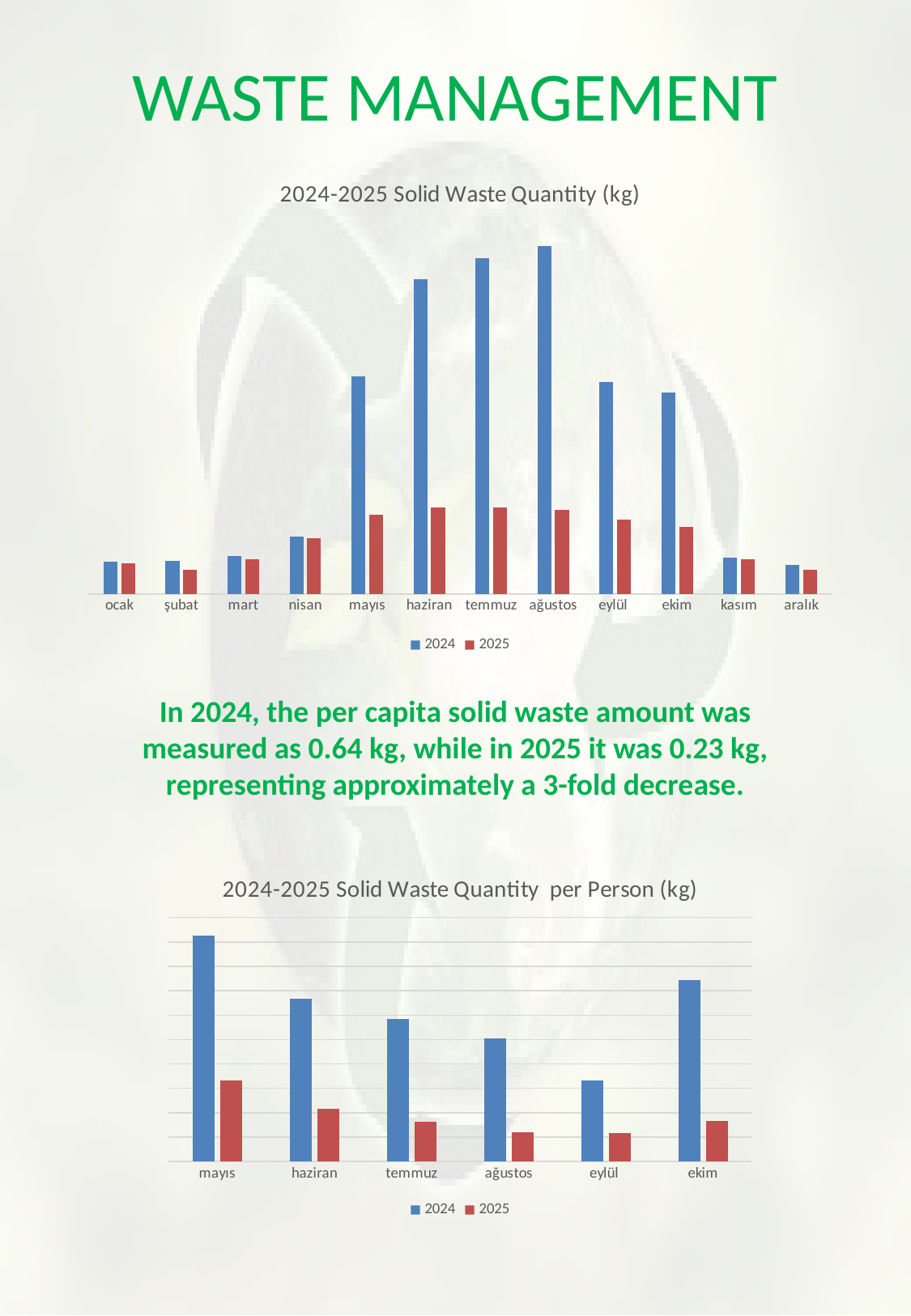
In the top chart, 2024-2025 Solid Waste Quantity (kg), how many series does the legend list? 2 What kind of chart is the top chart, 2024-2025 Solid Waste Quantity (kg)? bar chart In the top chart, 2024-2025 Solid Waste Quantity (kg), how many months are shown on the x axis? 12 In the bottom chart, 2024-2025 Solid Waste Quantity per Person (kg), which month has the highest 2025 bar? mayıs In the top chart, 2024-2025 Solid Waste Quantity (kg), which is larger for temmuz: the 2024 value or the 2025 value? 2024 In the top chart, 2024-2025 Solid Waste Quantity (kg), which is larger for 2024: mayıs or ağustos? ağustos In the bottom chart, 2024-2025 Solid Waste Quantity per Person (kg), how many months are shown on the x axis? 6 In the bottom chart, 2024-2025 Solid Waste Quantity per Person (kg), which month has the highest 2024 bar? mayıs In the bottom chart, 2024-2025 Solid Waste Quantity per Person (kg), do the 2024 values rise or fall from mayıs to eylül? fall In the top chart, 2024-2025 Solid Waste Quantity (kg), which month has the highest 2024 bar? ağustos In the bottom chart, 2024-2025 Solid Waste Quantity per Person (kg), which month has the lowest 2024 bar? eylül What are the two legend entries in the bottom chart, 2024-2025 Solid Waste Quantity per Person (kg)? 2024 and 2025